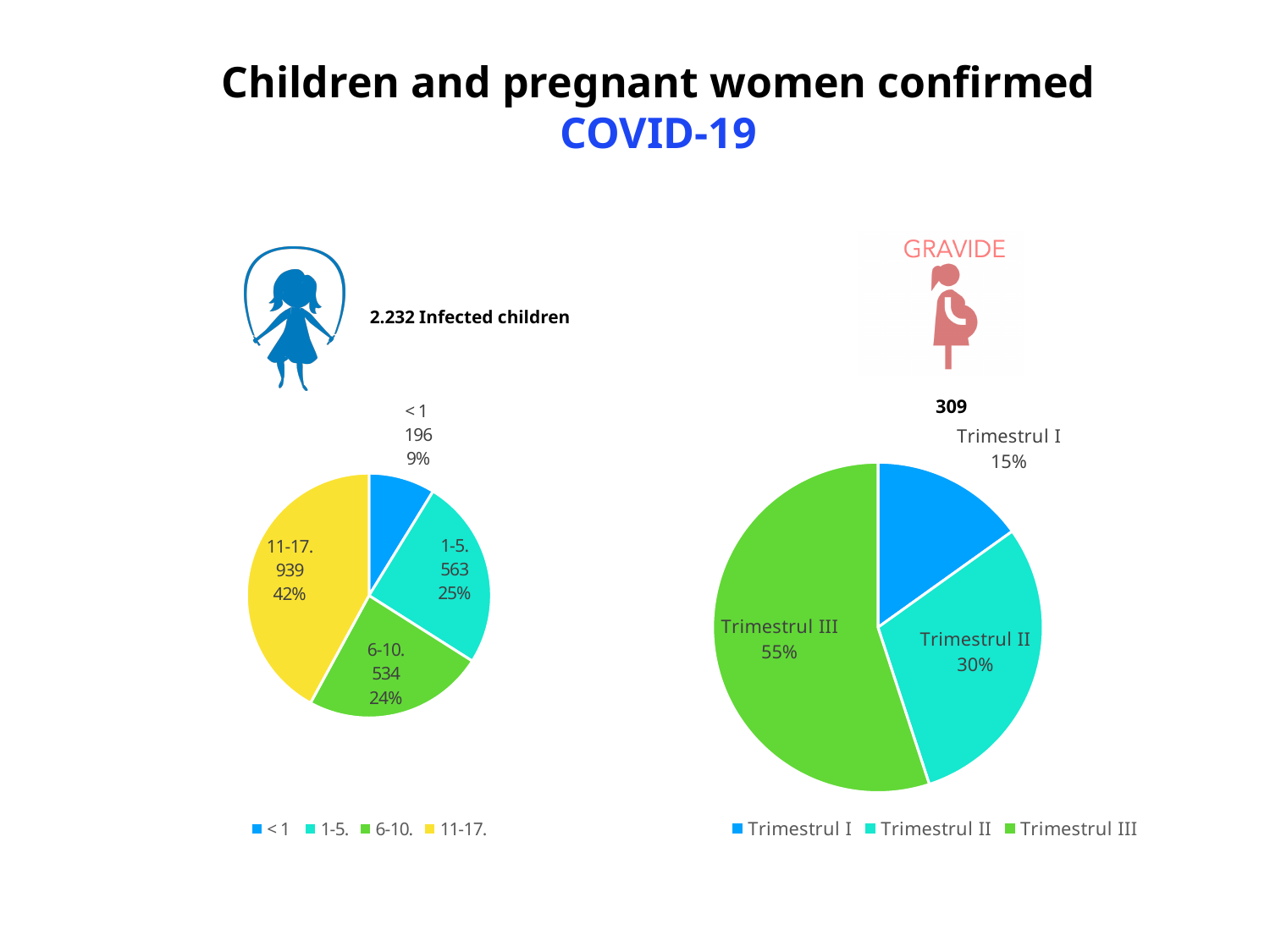
In the pregnant women pie chart on the right, what share does Trimestrul II have? 30% In the children pie chart on the left, what is the difference between the number of infected children aged 11-17. and those aged < 1? 743 In the pregnant women pie chart on the right, which is larger: the share for Trimestrul I or Trimestrul II? Trimestrul II In the pregnant women pie chart on the right, which trimester has the smallest share? Trimestrul I In the children pie chart on the left, how many age categories are shown? 4 How many entries does the legend of the pregnant women chart on the right list? 3 In the children pie chart on the left, which age group has the smallest number of infected children? < 1 In the children pie chart on the left, what percentage share does the 1-5. age group have? 25% In the children pie chart on the left, how many infected children are in the 11-17. age group? 939 What type of chart is used on the right side of the slide for pregnant women? Pie chart In the pregnant women pie chart on the right, which trimester has the largest share? Trimestrul III In the children pie chart on the left, which age group has the largest number of infected children? 11-17.